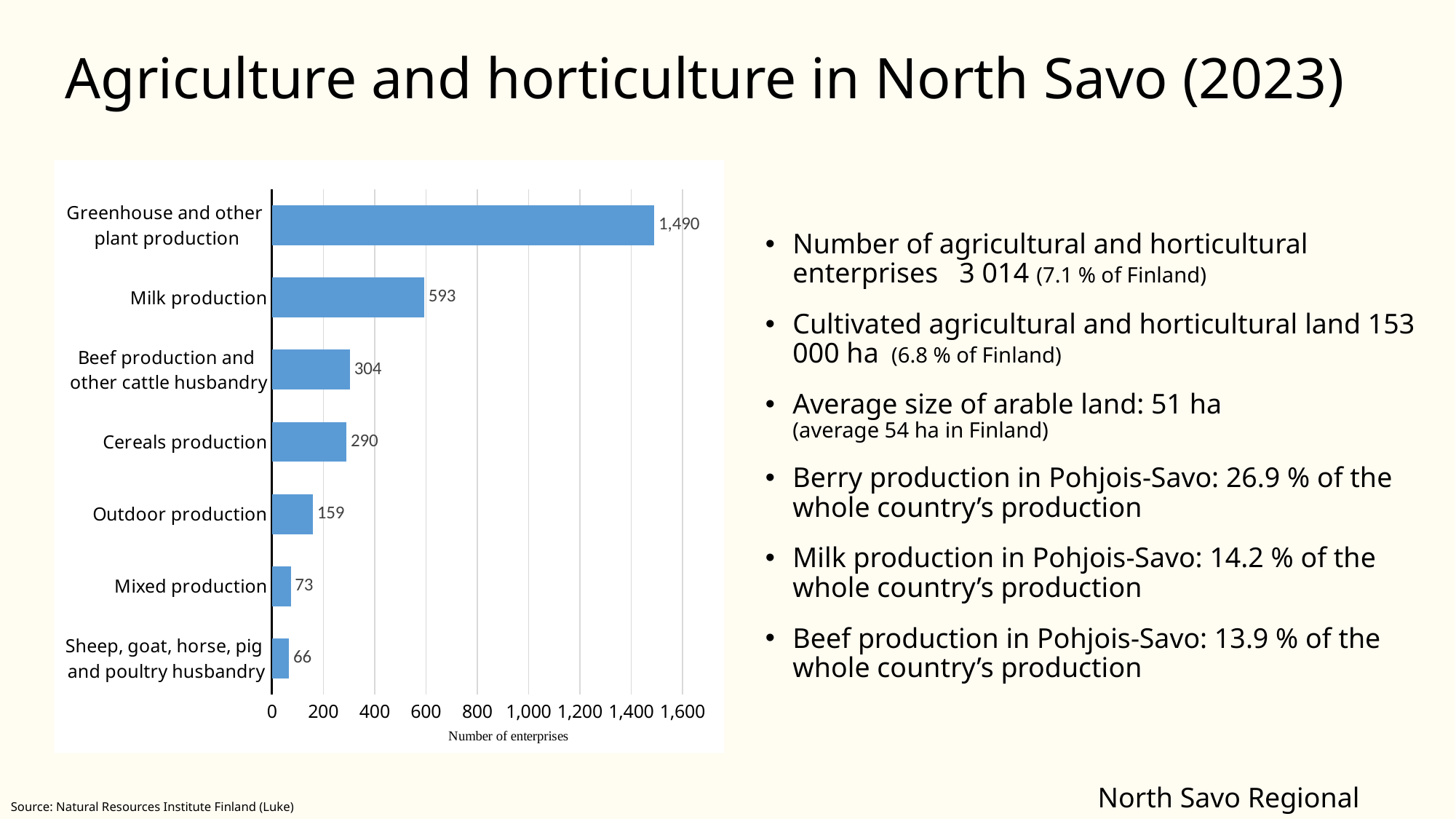
Which is larger, Cereals production or Outdoor production? Cereals production What is the number of enterprises for Greenhouse and other plant production? 1,490 How many categories are shown in the bar chart? 7 What is the difference between Milk production and Beef production and other cattle husbandry? 289 How many enterprises are shown for Milk production? 593 What is the value for Outdoor production? 159 Is the value for Beef production and other cattle husbandry greater or less than 400? less What is the label of the horizontal axis? Number of enterprises What is the difference between Mixed production and Sheep, goat, horse, pig and poultry husbandry? 7 Which category has the lowest number of enterprises? Sheep, goat, horse, pig and poultry husbandry Which category has the highest number of enterprises? Greenhouse and other plant production What kind of chart is shown on the slide? Bar chart